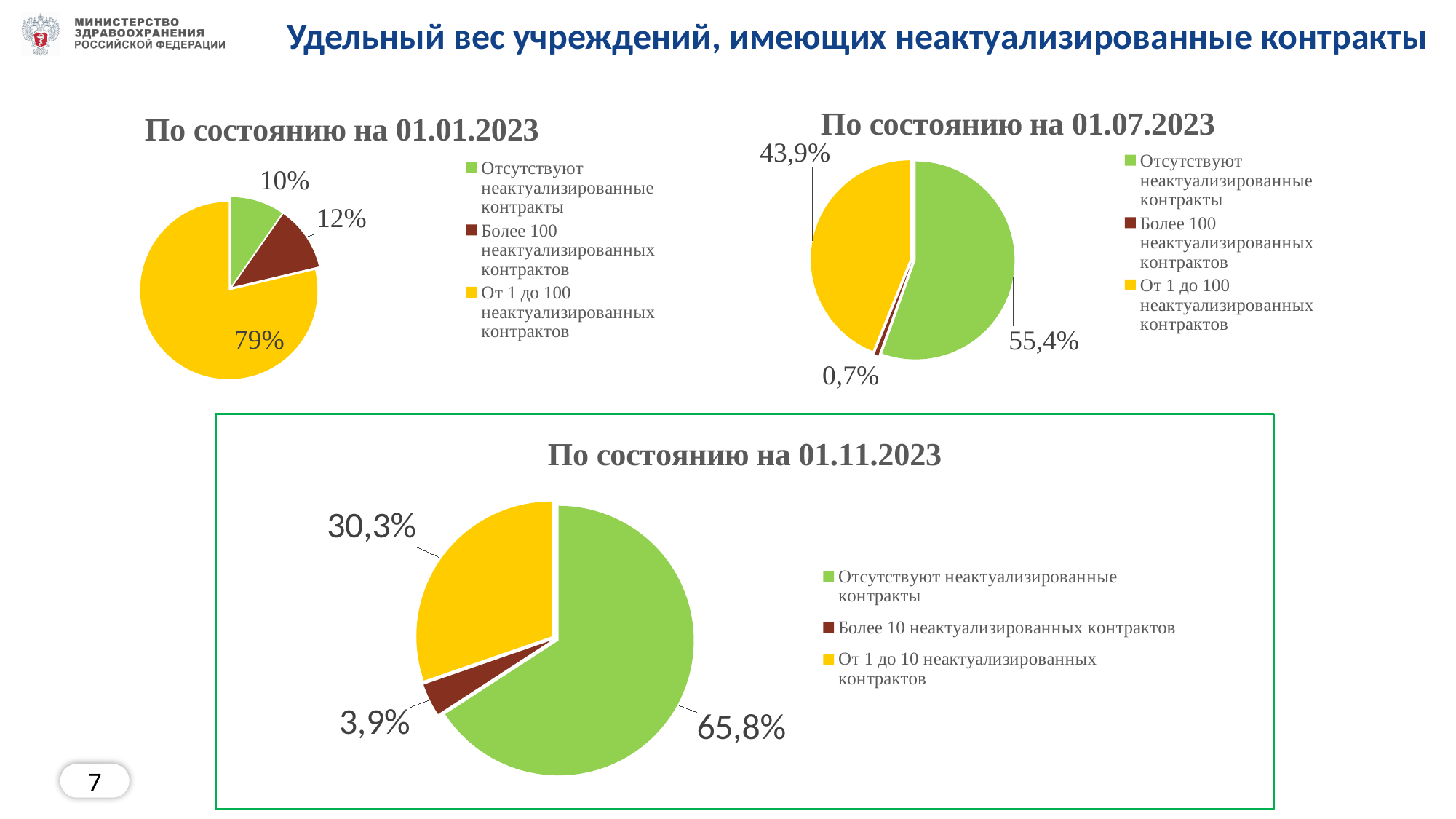
How many slices does the chart "По состоянию на 01.01.2023" have? 3 In the chart "По состоянию на 01.11.2023", which is larger: the share for "От 1 до 10 неактуализированных контрактов" or the share for "Более 10 неактуализированных контрактов"? От 1 до 10 неактуализированных контрактов In the chart "По состоянию на 01.01.2023", what share is shown for "От 1 до 100 неактуализированных контрактов"? 79% In the chart "По состоянию на 01.11.2023", which category has the smallest slice? Более 10 неактуализированных контрактов What kind of chart is "По состоянию на 01.11.2023"? Pie chart How many charts are shown on the slide? 3 In the chart "По состоянию на 01.01.2023", which category has the largest slice? От 1 до 100 неактуализированных контрактов In the chart "По состоянию на 01.07.2023", what share is shown for "Более 100 неактуализированных контрактов"? 0,7% In the chart "По состоянию на 01.01.2023", what share is shown for "Отсутствуют неактуализированные контракты"? 10% In the chart "По состоянию на 01.11.2023", what share is shown for "Отсутствуют неактуализированные контракты"? 65,8% In the chart "По состоянию на 01.07.2023", what is the difference between the shares for "Отсутствуют неактуализированные контракты" and "От 1 до 100 неактуализированных контрактов"? 11,5% In the chart "По состоянию на 01.07.2023", which category has the largest slice? Отсутствуют неактуализированные контракты